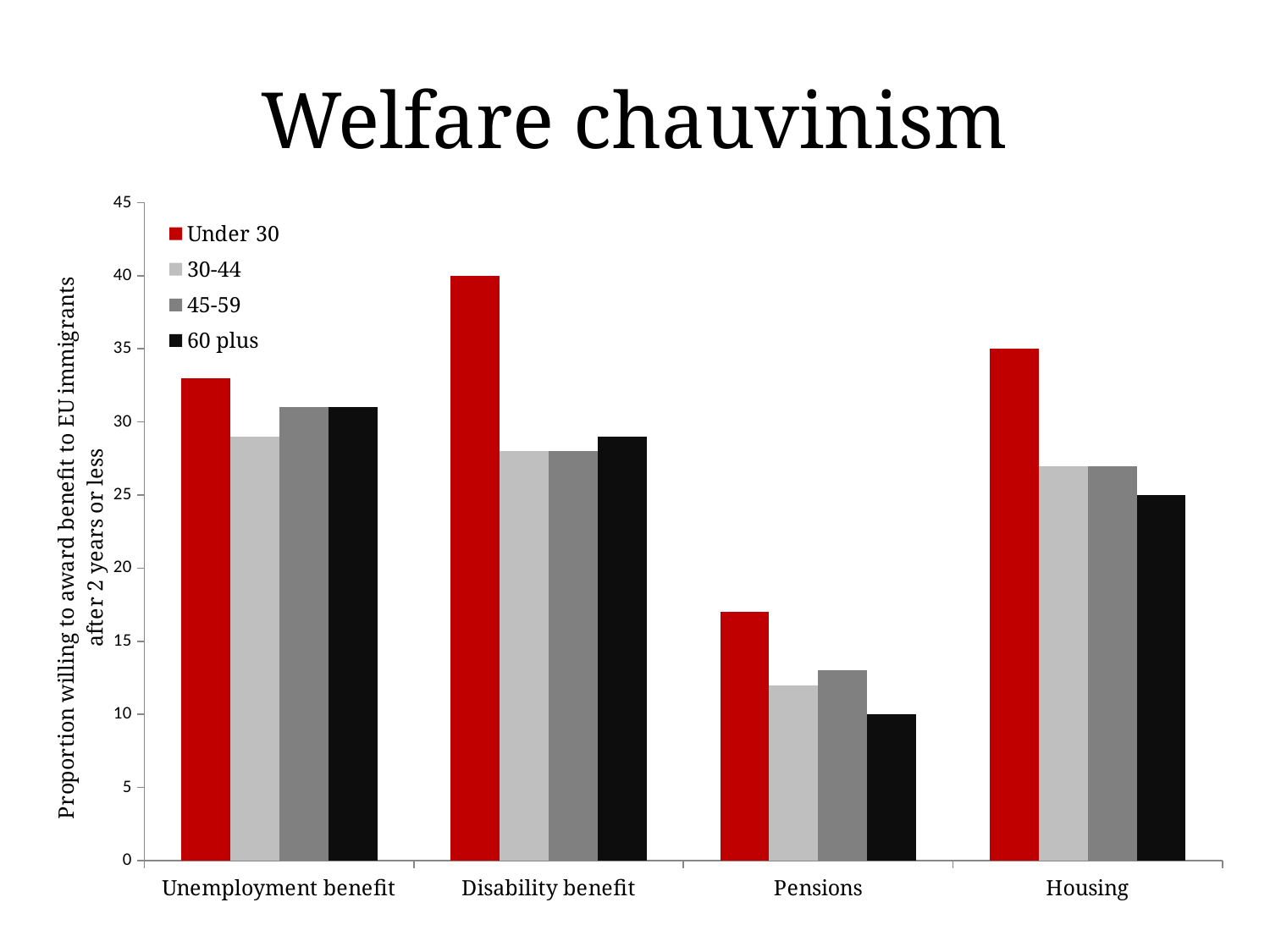
What is the value for 60 plus in the Pensions category? 10 Is the value for Under 30 in the Unemployment benefit category greater or less than 30? greater Which series is shown in red in the legend? Under 30 Which is larger: the Under 30 value for Disability benefit or the Under 30 value for Housing? Disability benefit For which benefit category is the 60 plus bar lowest? Pensions How many benefit categories are shown on the x axis? 4 How many series does the legend list? 4 What is the value for Under 30 in the Disability benefit category? 40 Is the value for 30-44 in the Disability benefit category greater or less than 30? less What kind of chart is shown on the slide? bar chart For which benefit category is the Under 30 bar highest? Disability benefit What is the title of the slide? Welfare chauvinism